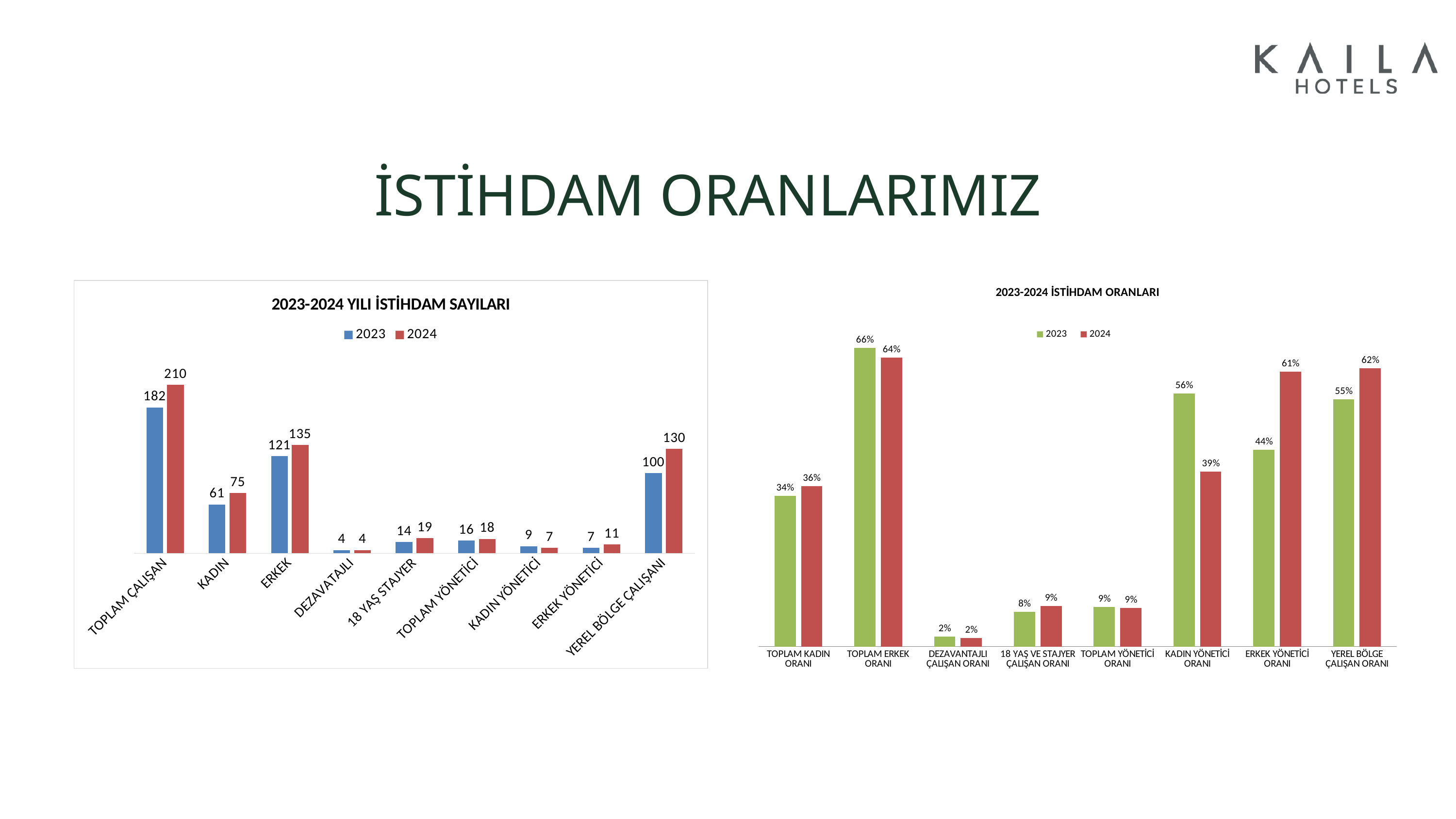
In the chart titled '2023-2024 YILI İSTİHDAM SAYILARI', what is the 2023 value for KADIN? 61 In the chart titled '2023-2024 İSTİHDAM ORANLARI', what is the 2024 value for YEREL BÖLGE ÇALIŞAN ORANI? 62% In the chart titled '2023-2024 İSTİHDAM ORANLARI', which category has the highest 2023 value? TOPLAM ERKEK ORANI In the chart titled '2023-2024 YILI İSTİHDAM SAYILARI', what is the 2024 value for TOPLAM ÇALIŞAN? 210 In the chart titled '2023-2024 YILI İSTİHDAM SAYILARI', how many categories are shown on the x axis? 9 In the chart titled '2023-2024 YILI İSTİHDAM SAYILARI', is the 2023 value for KADIN YÖNETİCİ larger or smaller than the 2024 value? larger In the chart titled '2023-2024 YILI İSTİHDAM SAYILARI', which category has the lowest 2023 value? DEZAVATAJLI In the chart titled '2023-2024 İSTİHDAM ORANLARI', what is the 2023 value for KADIN YÖNETİCİ ORANI? 56% In the chart titled '2023-2024 İSTİHDAM ORANLARI', how many series does the legend list? 2 What kind of chart is the chart titled '2023-2024 İSTİHDAM ORANLARI'? bar chart In the chart titled '2023-2024 YILI İSTİHDAM SAYILARI', what is the difference between the 2024 and 2023 values for ERKEK? 14 In the chart titled '2023-2024 YILI İSTİHDAM SAYILARI', which category has the highest 2024 value? TOPLAM ÇALIŞAN